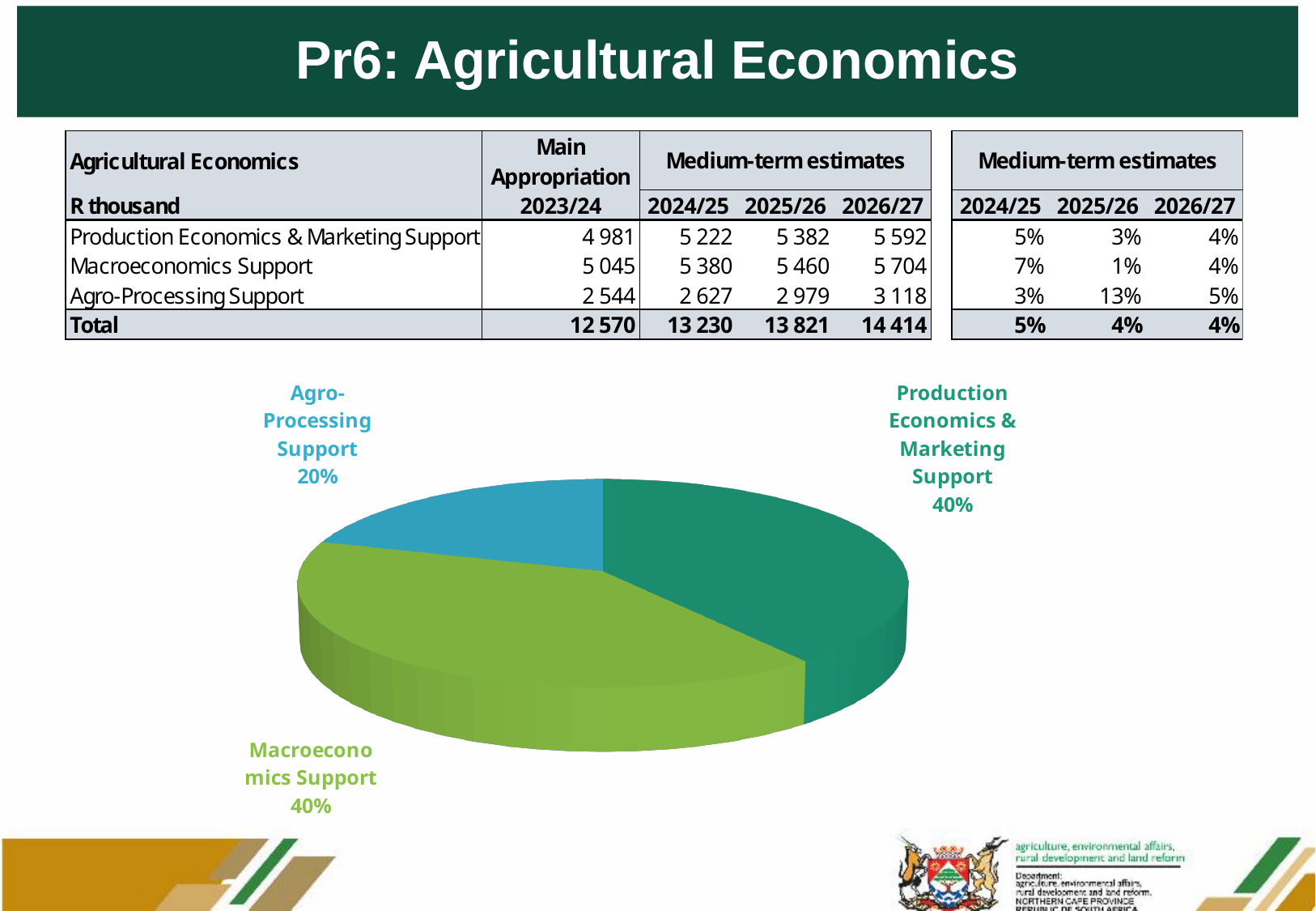
What colour is the Agro-Processing Support slice in the pie chart? Blue Do Production Economics & Marketing Support and Macroeconomics Support have the same share of the pie? Yes What kind of chart is shown on the slide? Pie chart Which slice of the pie chart is shown in dark green? Production Economics & Marketing Support What share of the pie does Production Economics & Marketing Support have? 40% By how many percentage points does Macroeconomics Support exceed Agro-Processing Support in the pie chart? 20 percentage points Which is larger in the pie chart, Agro-Processing Support or Production Economics & Marketing Support? Production Economics & Marketing Support How many slices does the pie chart have? 3 What share of the pie does Agro-Processing Support have? 20% Which slice of the pie chart is the smallest? Agro-Processing Support What share of the pie does Macroeconomics Support have? 40%